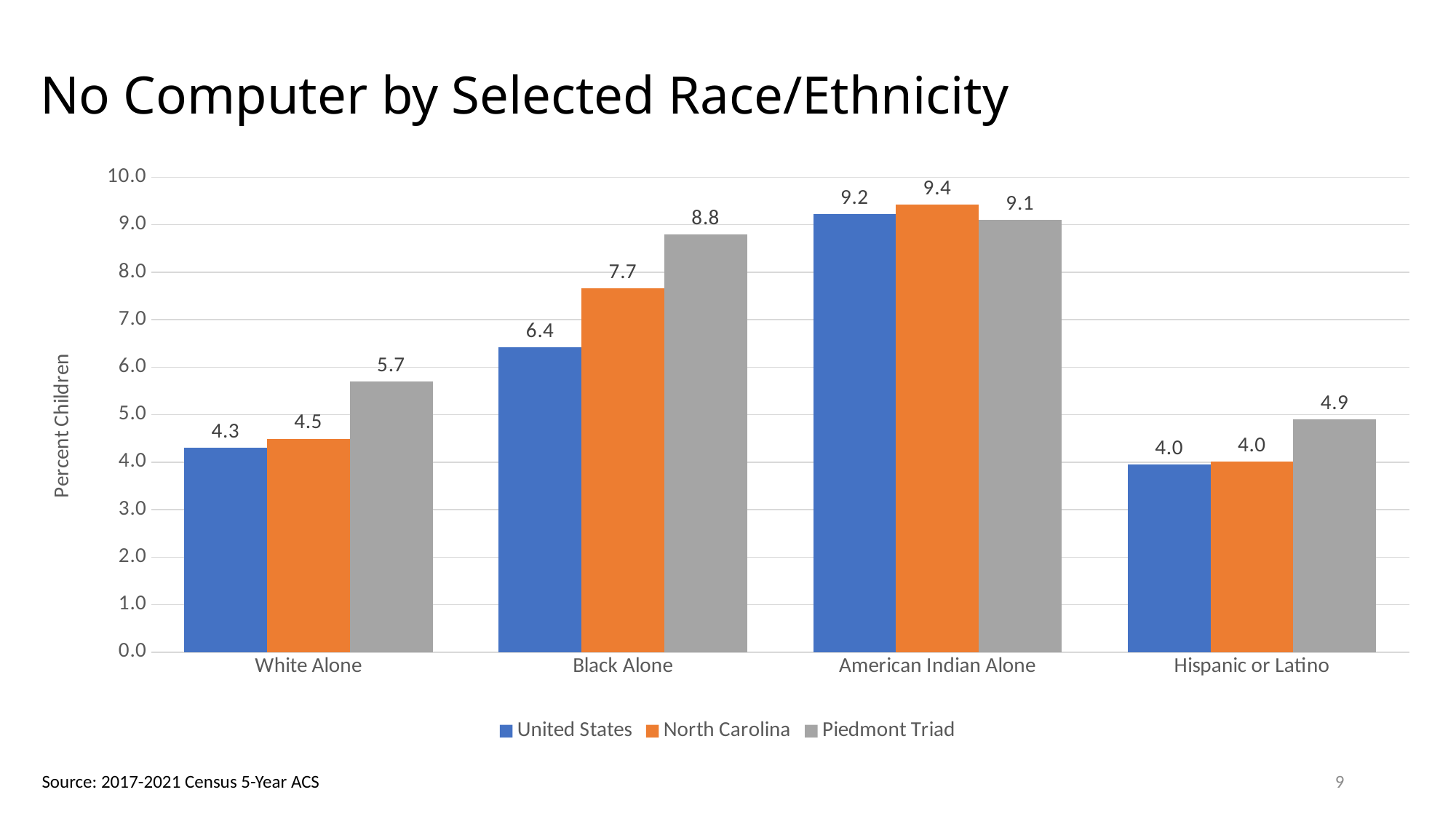
Which race/ethnicity category has the lowest United States value? Hispanic or Latino What is the label on the vertical axis? Percent Children What is the Piedmont Triad value for Black Alone? 8.8 What is the North Carolina value for American Indian Alone? 9.4 Is the North Carolina value for Black Alone greater or less than 7.0? greater Which race/ethnicity category has the highest Piedmont Triad value? American Indian Alone What is the United States value for White Alone? 4.3 What kind of chart is shown on the slide? Bar chart Which is larger for White Alone: the North Carolina value or the Piedmont Triad value? Piedmont Triad How many race/ethnicity categories are shown on the x axis? 4 How many series does the legend list? 3 What is the difference between the Piedmont Triad and United States values for Black Alone? 2.4